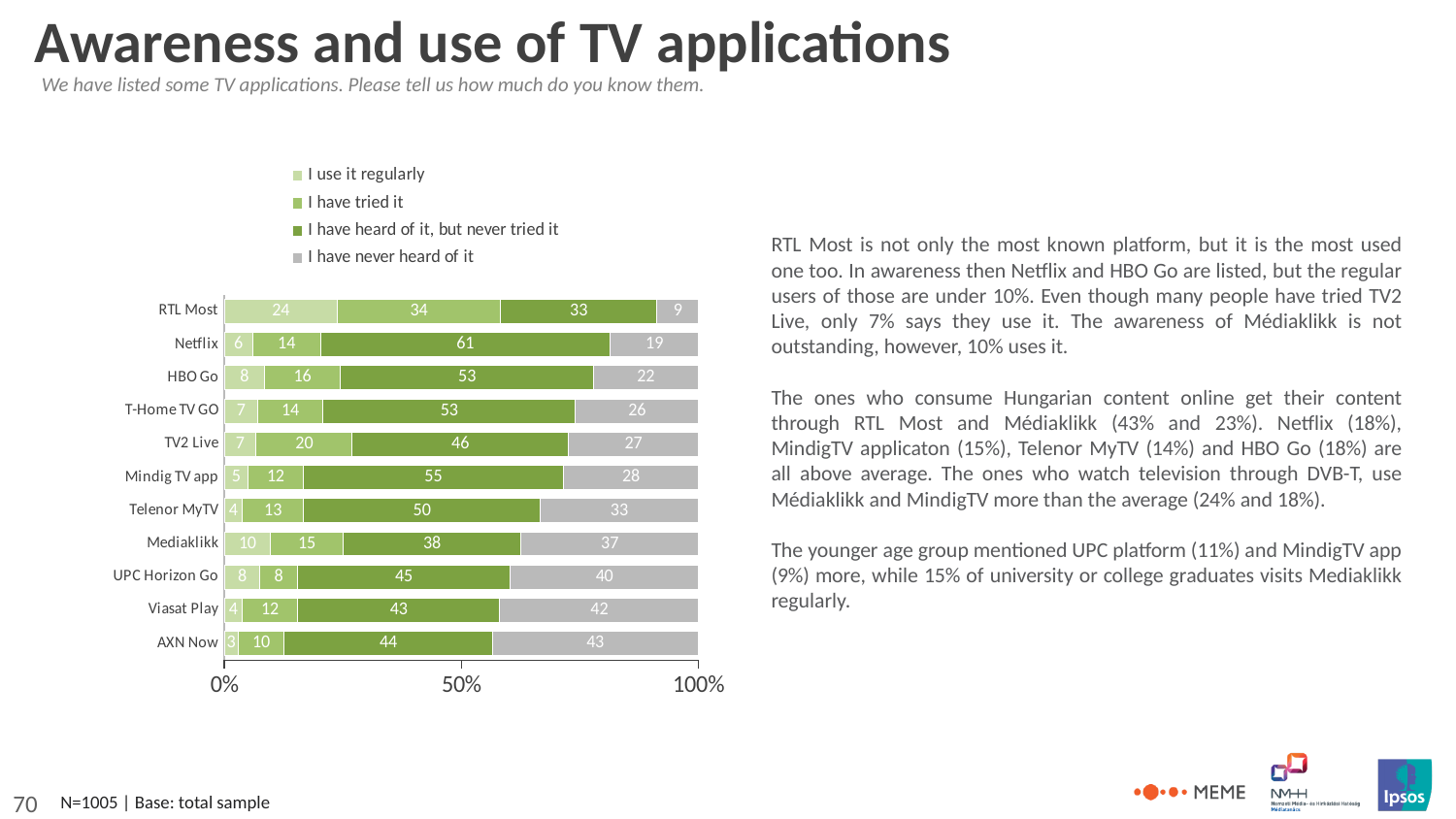
Which application has the highest 'I use it regularly' value? RTL Most What is the value for 'I have heard of it, but never tried it' for Netflix? 61 How many series does the legend list? 4 What is the difference between the 'I have never heard of it' values for Viasat Play and Netflix? 23 Which application has the lowest 'I have never heard of it' value? RTL Most Which legend entry is shown in grey? I have never heard of it Which is larger: the 'I have tried it' value for TV2 Live or for HBO Go? TV2 Live How many TV applications are listed on the chart? 11 What is the total of the stacked bar for Mediaklikk? 100 What is the 'I have never heard of it' value for AXN Now? 43 What kind of chart is shown on the slide? Stacked bar chart What percentage of respondents say they use RTL Most regularly? 24